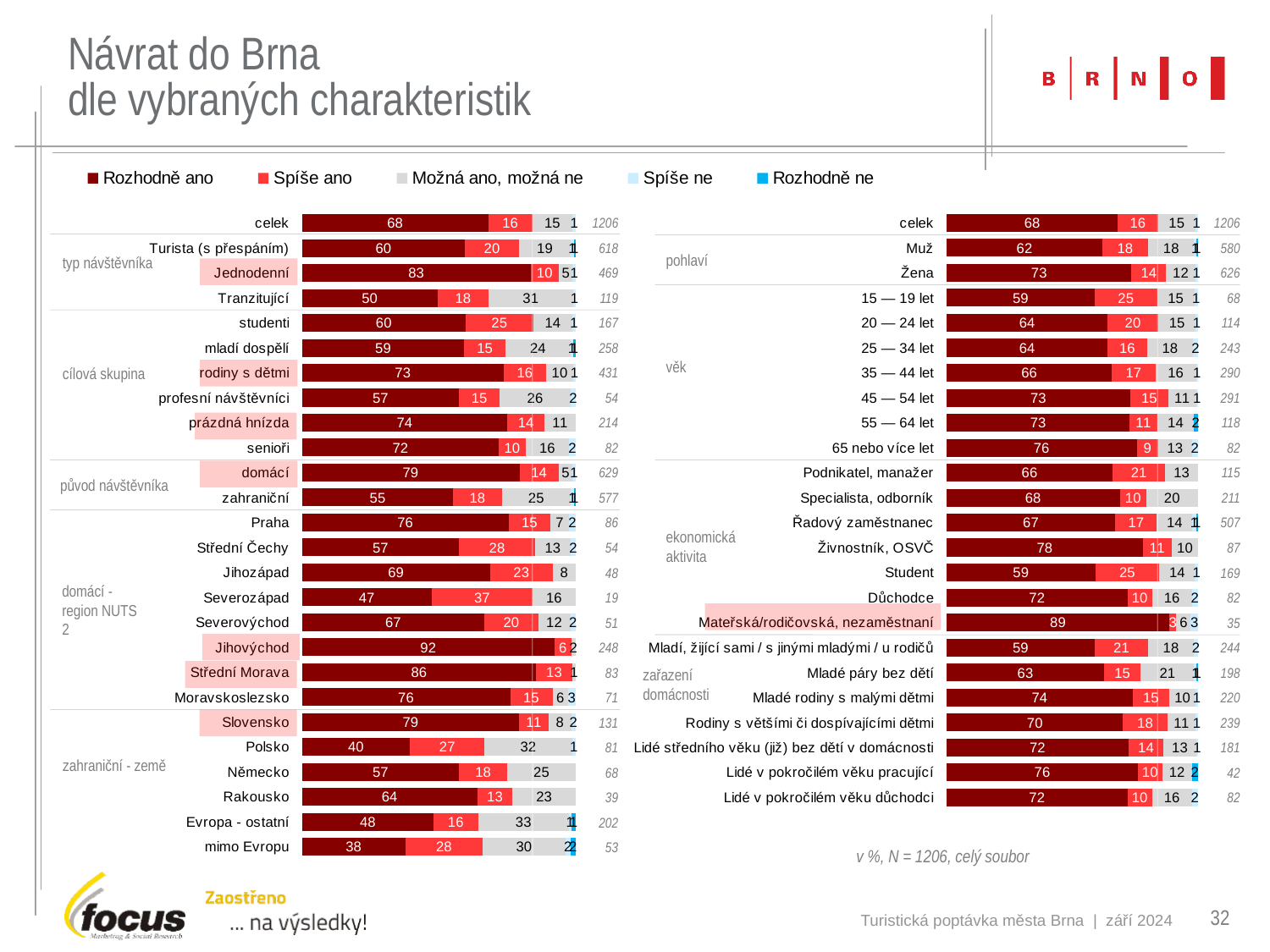
In the left chart, what is the 'Možná ano, možná ne' value for Polsko? 32 What kind of chart is shown on the slide? Stacked bar chart How many series does the legend list? 5 In the right chart, what is the difference between the 'Rozhodně ano' values for Žena and Muž? 11 In the right chart, what is the 'Rozhodně ano' value for Mateřská/rodičovská, nezaměstnaní? 89 In the left chart, what is the 'Spíše ano' value for Severozápad? 37 In the left chart, what is the 'Rozhodně ano' value for Jihovýchod? 92 In the right chart, which category has the highest 'Rozhodně ano' value? Mateřská/rodičovská, nezaměstnaní In the right chart, which has the larger 'Rozhodně ano' value, Muž or Žena? Žena In the left chart, which category has the highest 'Rozhodně ano' value? Jihovýchod In the right chart, do the 'Rozhodně ano' values generally rise or fall from the 15 — 19 let group to the 65 nebo více let group? Rise In the left chart, which category has the lowest 'Rozhodně ano' value? mimo Evropu